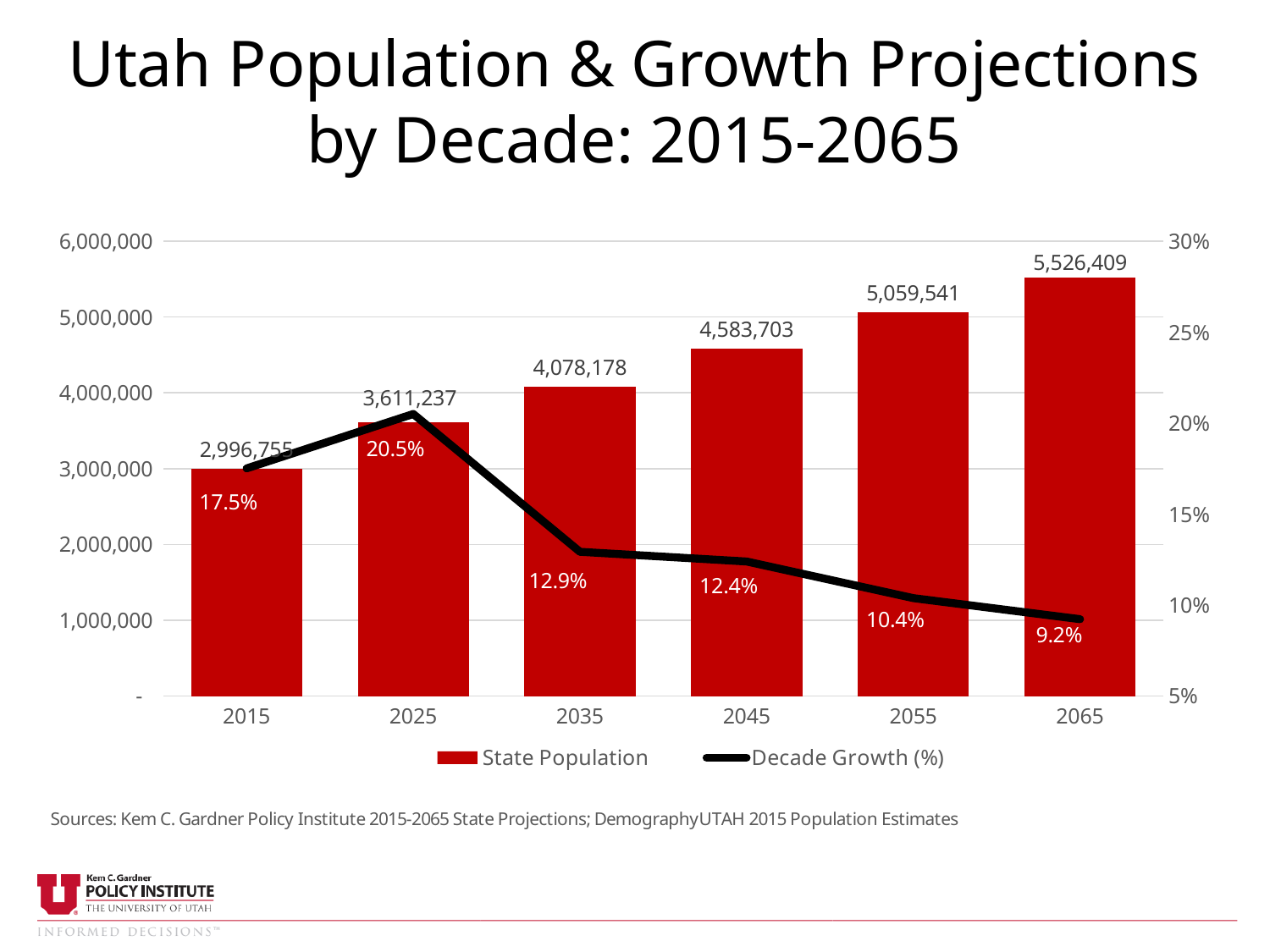
Is the State Population for 2035 greater or less than 4,000,000? greater Which year has the highest Decade Growth (%)? 2025 How many series does the legend list? 2 What is the Decade Growth (%) value for 2025? 20.5% Does the Decade Growth (%) rise or fall from 2025 to 2065? fall Which year has the lowest State Population? 2015 What is the projected State Population for 2065? 5,526,409 What is the difference in State Population between 2065 and 2055? 466,868 How many years are shown on the x axis? 6 Which is larger, the Decade Growth (%) for 2035 or for 2055? 2035 What is the projected State Population for 2045? 4,583,703 What colour are the State Population bars? red